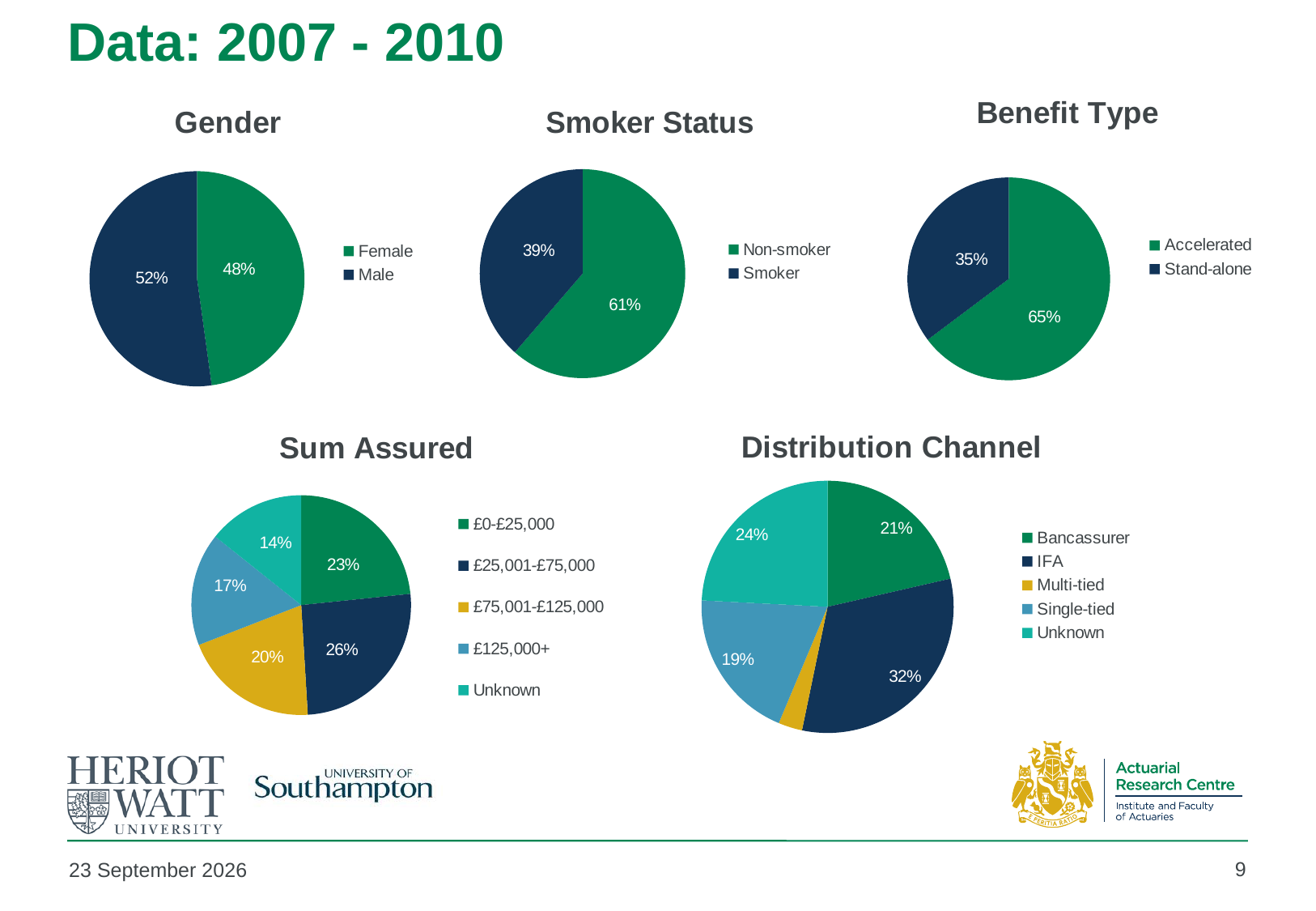
In the Benefit Type chart, what percentage is Stand-alone? 35% In the Benefit Type chart, what is the difference in percentage points between Accelerated and Stand-alone? 30 In the Distribution Channel chart, which category has the smallest share? Multi-tied In the Smoker Status chart, what percentage is Non-smoker? 61% In the Sum Assured chart, which is larger: £0-£25,000 or £75,001-£125,000? £0-£25,000 In the Distribution Channel chart, what percentage is IFA? 32% In the Distribution Channel chart, which category has the largest share? IFA What type of chart is the Gender chart? Pie chart In the Gender chart, what share of the pie is Male? 52% In the Sum Assured chart, which category has the smallest share? Unknown How many categories does the legend of the Sum Assured chart list? 5 In the Sum Assured chart, what percentage is £25,001-£75,000? 26%